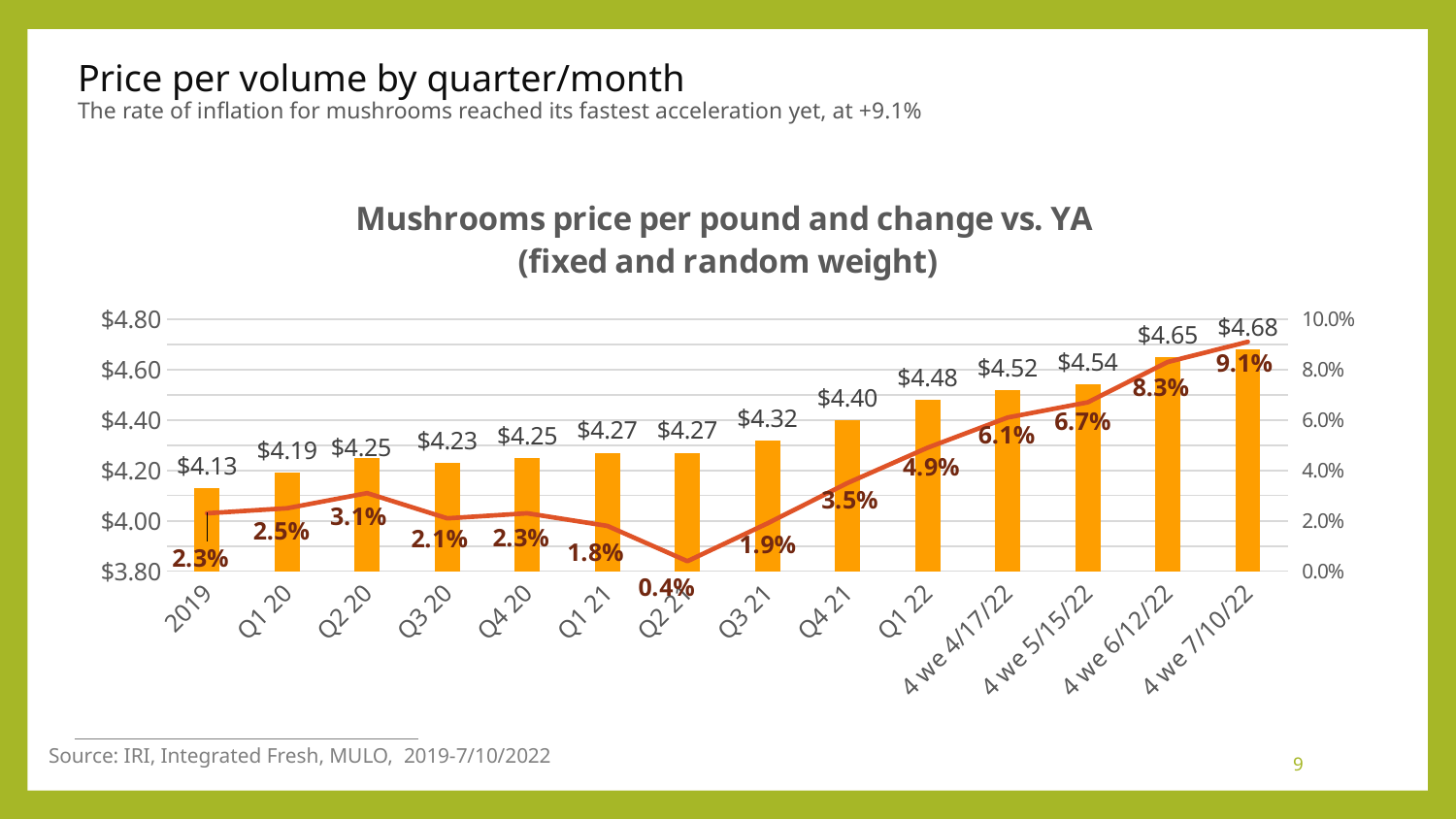
Which period has the highest price per pound? 4 we 7/10/22 What is the mushroom price per pound for Q4 21? $4.40 What is the price per pound for the 4 we 6/12/22 period? $4.65 What is the change vs. YA shown for Q2 21? 0.4% Does the change vs. YA rise or fall from Q2 21 to 4 we 7/10/22? Rise What is the change vs. YA for 4 we 5/15/22? 6.7% What kind of chart is this? Combination bar and line chart What is the difference in price per pound between 4 we 7/10/22 and 2019? $0.55 Which period has the lowest change vs. YA? Q2 21 What is the title of the chart? Mushrooms price per pound and change vs. YA (fixed and random weight) How many periods are shown on the x axis? 14 Which is larger, the change vs. YA for Q1 22 or for Q4 21? Q1 22